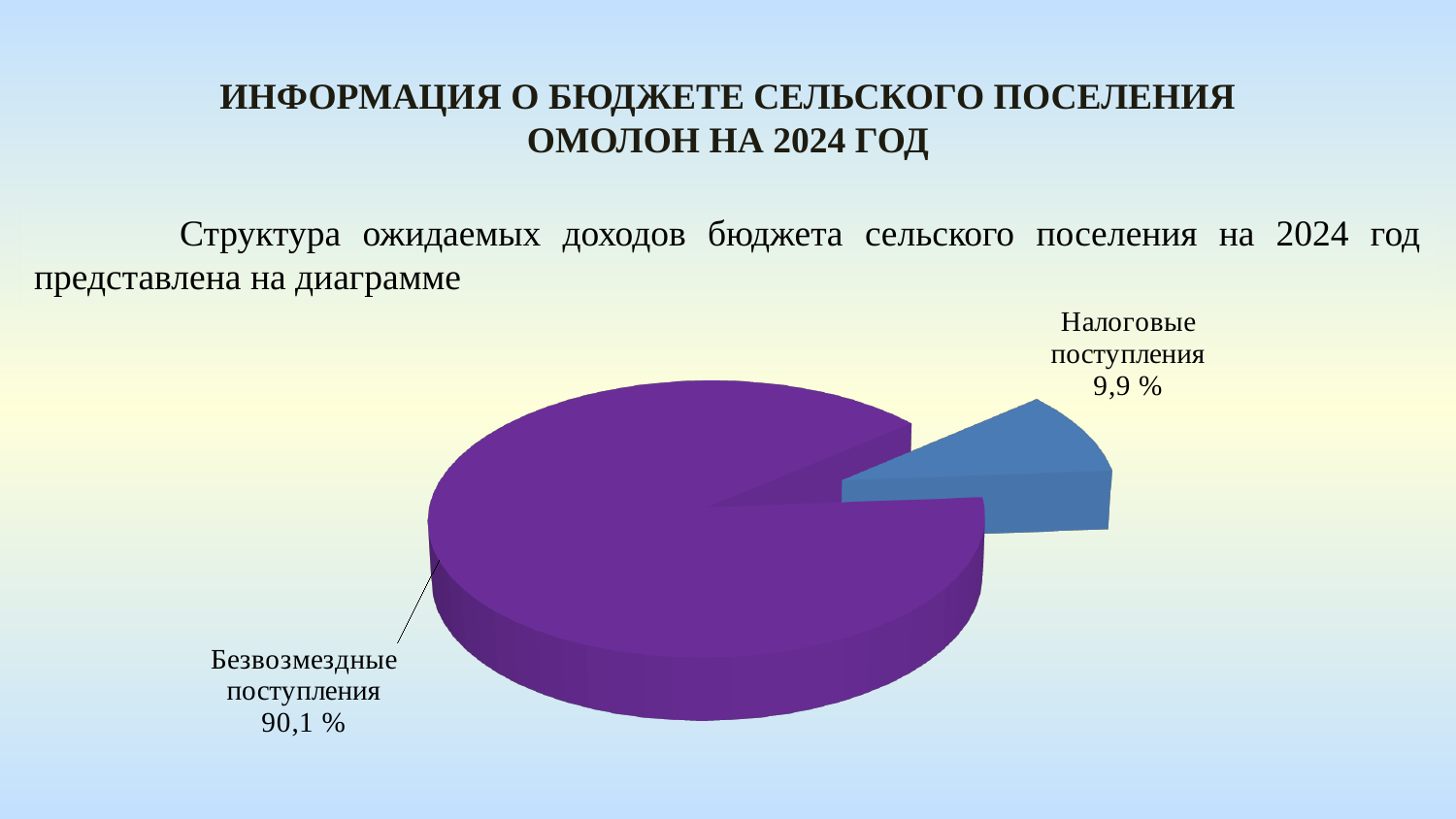
What is the value shown for Безвозмездные поступления? 90,1 % How many slices does the pie chart have? 2 What is the difference between the shares of Безвозмездные поступления and Налоговые поступления? 80,2 % Which slice of the pie chart is the largest? Безвозмездные поступления Which slice of the pie chart is the smallest? Налоговые поступления Which is larger, Безвозмездные поступления or Налоговые поступления? Безвозмездные поступления What share of the pie is labelled Налоговые поступления? 9,9 % What share of the pie is labelled Безвозмездные поступления? 90,1 % What colour is the slice for Налоговые поступления? Blue What is the value shown for Налоговые поступления? 9,9 % What colour is the slice for Безвозмездные поступления? Purple What kind of chart is shown on the slide? Pie chart